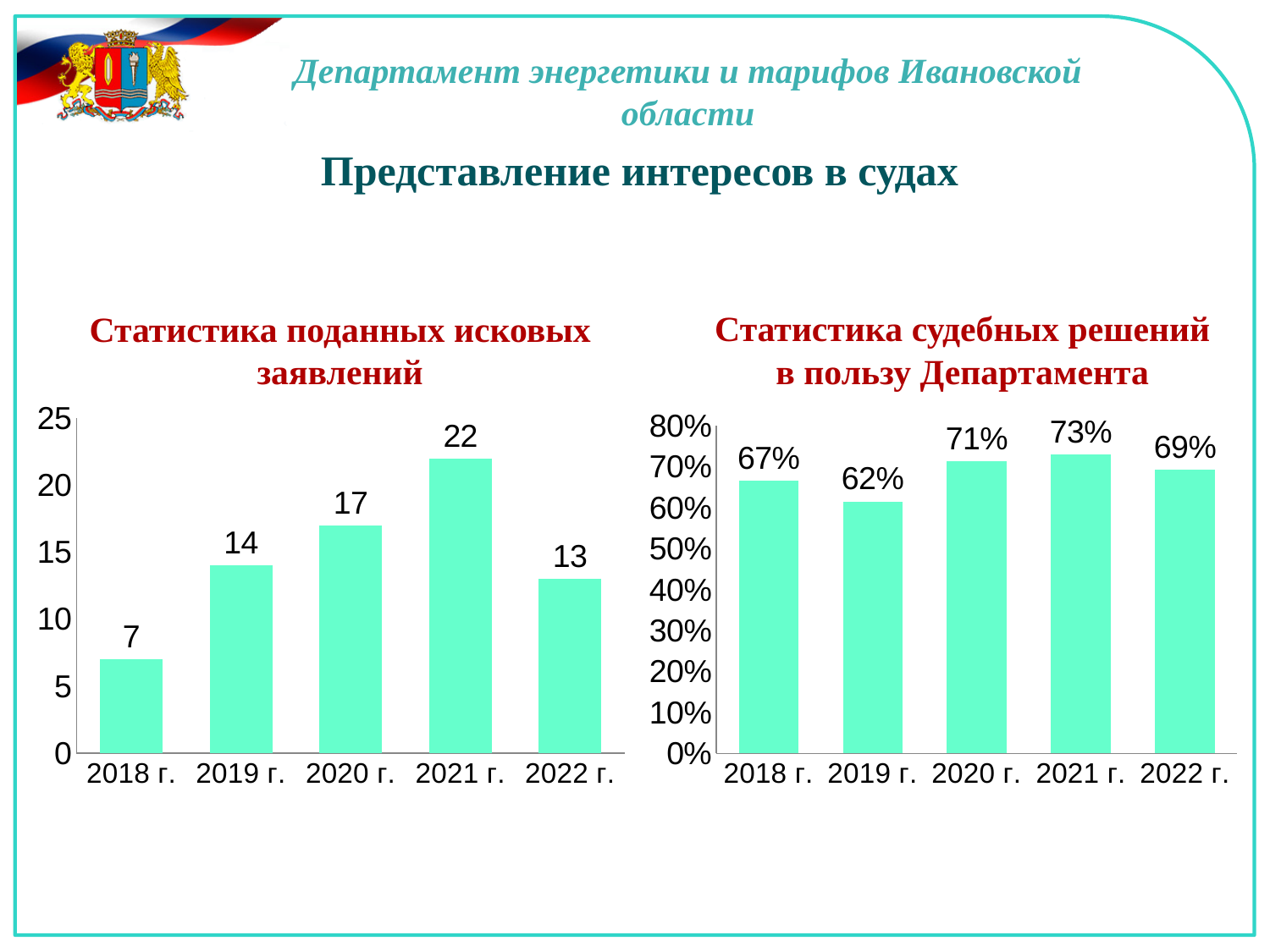
In the right chart (Статистика судебных решений в пользу Департамента), what is the difference between the values for 2021 г. and 2019 г.? 11% In the left chart (Статистика поданных исковых заявлений), do the values rise or fall from 2018 г. to 2021 г.? rise In the left chart (Статистика поданных исковых заявлений), how many years are shown on the x axis? 5 In the right chart (Статистика судебных решений в пользу Департамента), what is the value for 2019 г.? 62% In the left chart (Статистика поданных исковых заявлений), what is the difference between the values for 2021 г. and 2022 г.? 9 In the right chart (Статистика судебных решений в пользу Департамента), which is larger, the value for 2018 г. or 2022 г.? 2022 г. In the left chart (Статистика поданных исковых заявлений), is the value for 2020 г. greater or less than 15? greater In the left chart (Статистика поданных исковых заявлений), what is the value for 2021 г.? 22 What is the title of the left chart? Статистика поданных исковых заявлений In the right chart (Статистика судебных решений в пользу Департамента), which year has the highest value? 2021 г. In the left chart (Статистика поданных исковых заявлений), which year has the lowest value? 2018 г. What kind of chart is the right chart (Статистика судебных решений в пользу Департамента)? bar chart